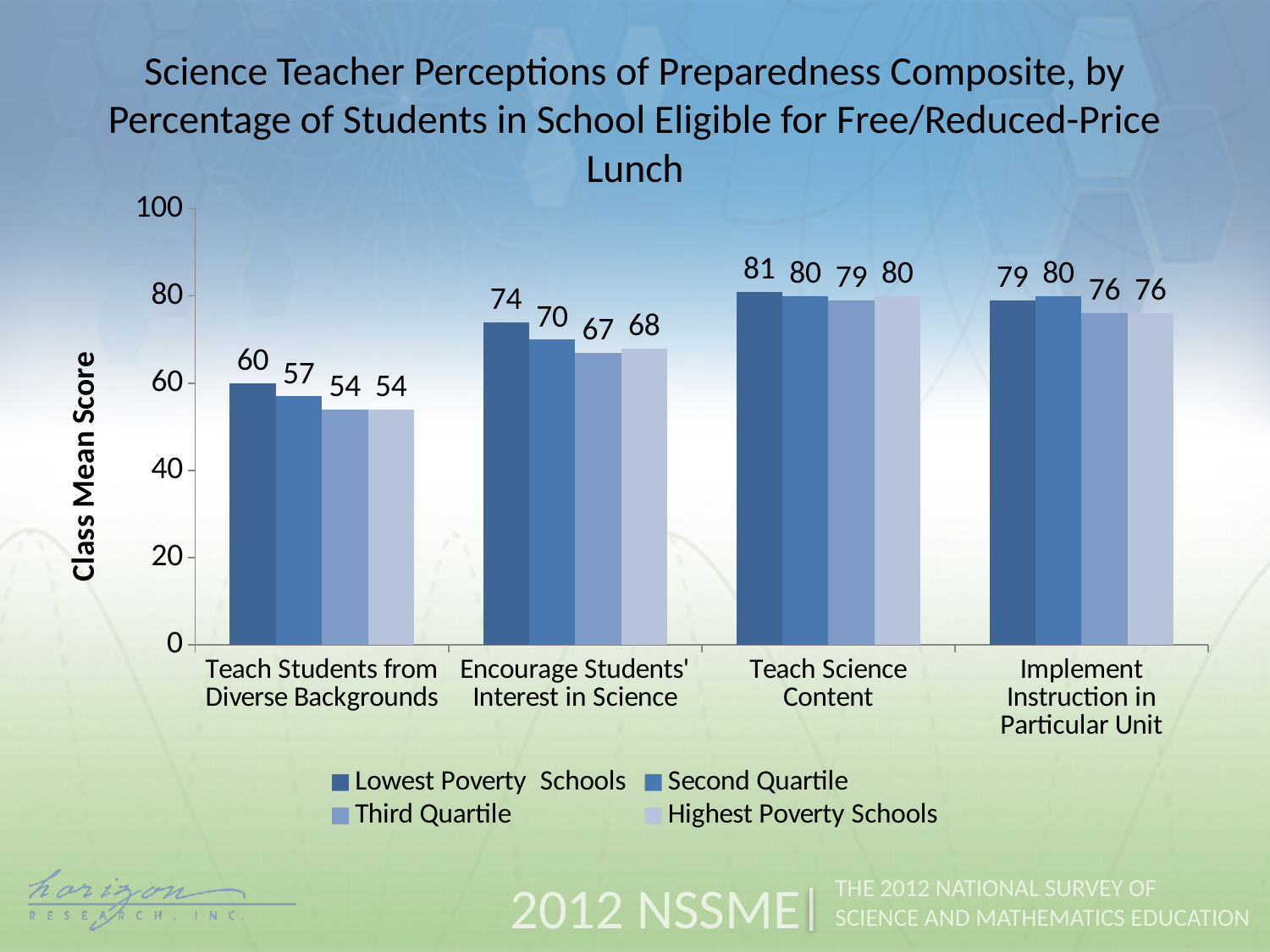
Which category has the lowest score for Second Quartile schools? Teach Students from Diverse Backgrounds What is the Class Mean Score for Third Quartile schools on Implement Instruction in Particular Unit? 76 What is the Class Mean Score for Highest Poverty Schools on Encourage Students' Interest in Science? 68 What is the difference between the Lowest Poverty Schools and Highest Poverty Schools scores for Teach Students from Diverse Backgrounds? 6 What kind of chart is shown on the slide? Bar chart Which category has the highest score for Lowest Poverty Schools? Teach Science Content Is the Second Quartile score for Teach Science Content greater or less than 60? greater What is the label of the vertical axis? Class Mean Score How many series does the legend list? 4 What is the Class Mean Score for Lowest Poverty Schools on Teach Students from Diverse Backgrounds? 60 How many categories are shown on the x axis? 4 For Encourage Students' Interest in Science, which is larger: the Lowest Poverty Schools score or the Third Quartile score? Lowest Poverty Schools